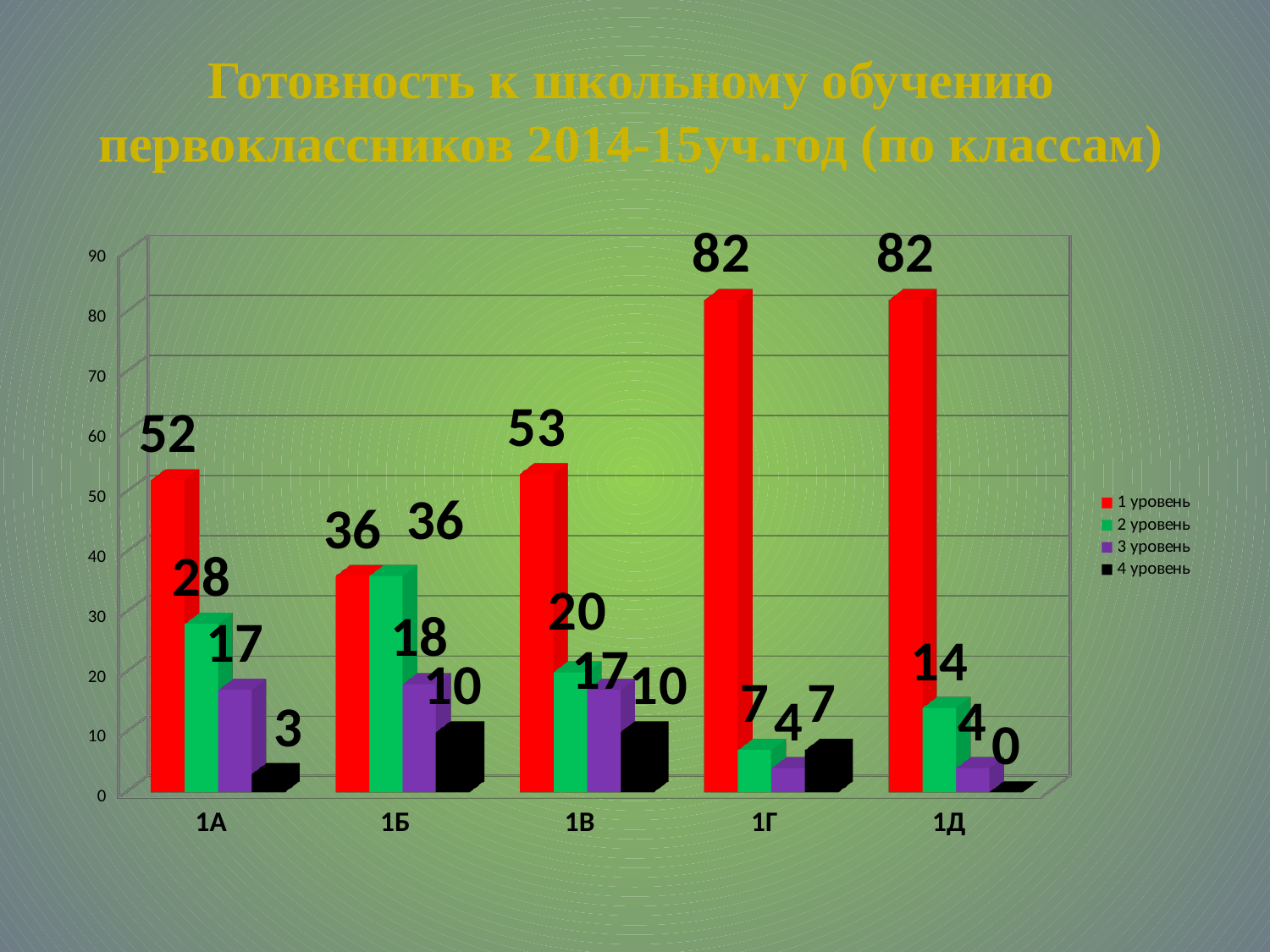
Which is larger: 2 уровень for 1В or 2 уровень for 1Д? 2 уровень for 1В What is the value of 1 уровень for class 1А? 52 Which colour represents 3 уровень in the legend? Purple What kind of chart is shown on the slide? Bar chart What is the value of 4 уровень for class 1Б? 10 What is the difference between the 1 уровень values for 1Г and 1А? 30 What is the value of 3 уровень for class 1Г? 4 How many classes are shown on the x axis? 5 What is the value of 2 уровень for class 1Д? 14 Which class has the lowest value for 1 уровень? 1Б Which class has the highest value for 2 уровень? 1Б How many series does the legend list? 4